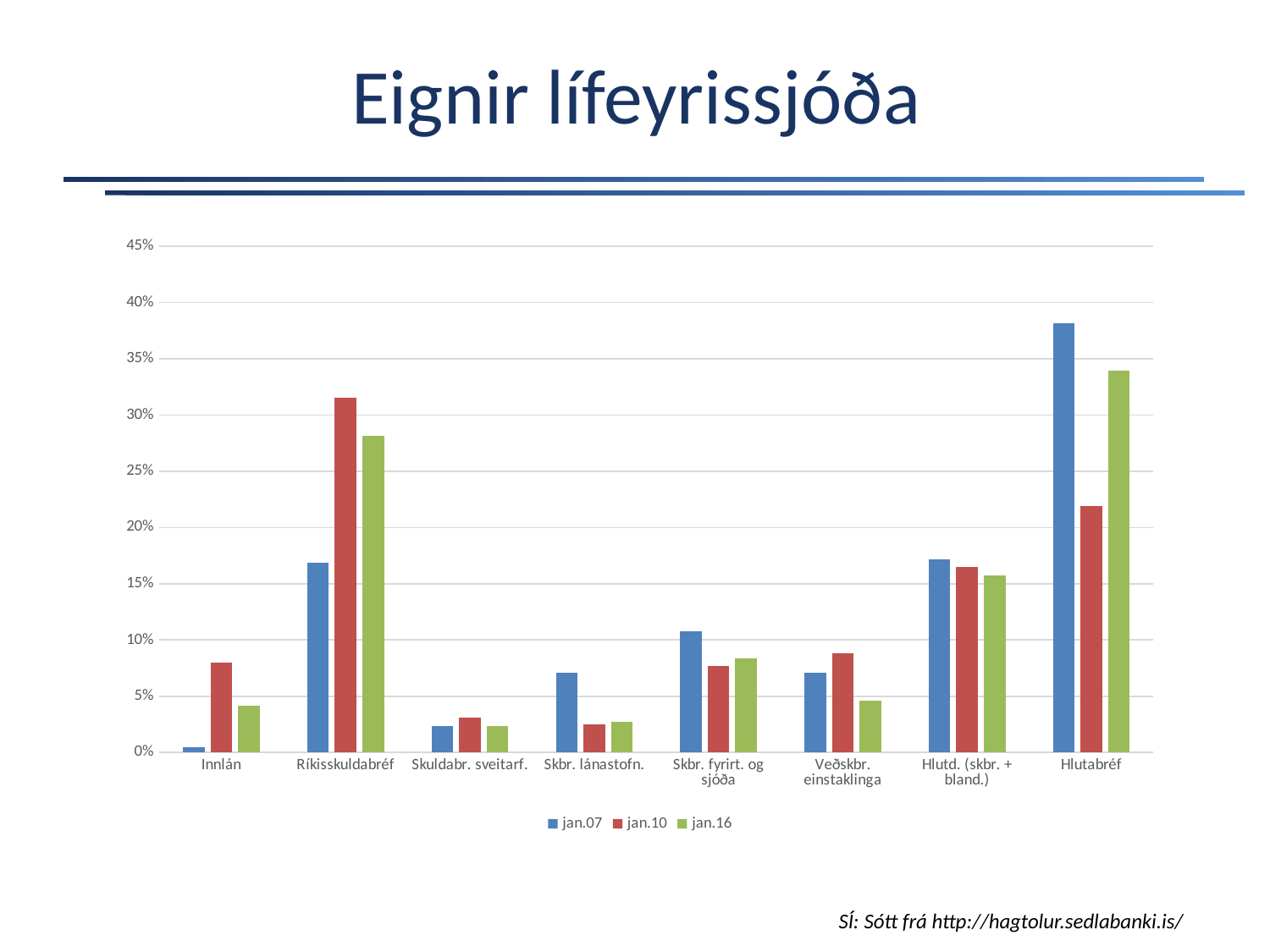
Is the jan.16 value for Innlán greater or less than 5%? less Which category has the highest value for jan.07? Hlutabréf Which category has the highest value for jan.10? Ríkisskuldabréf What is the title of the chart? Eignir lífeyrissjóða Is the jan.07 value for Hlutabréf greater or less than 35%? greater For Hlutabréf, which is larger: the jan.07 value or the jan.16 value? jan.07 For Innlán, which is larger: the jan.07 value or the jan.10 value? jan.10 What kind of chart is shown on the slide? bar chart How many categories are shown on the x axis? 8 Which category has the lowest value for jan.07? Innlán How many series does the legend list? 3 Is the jan.10 value for Ríkisskuldabréf greater or less than 30%? greater